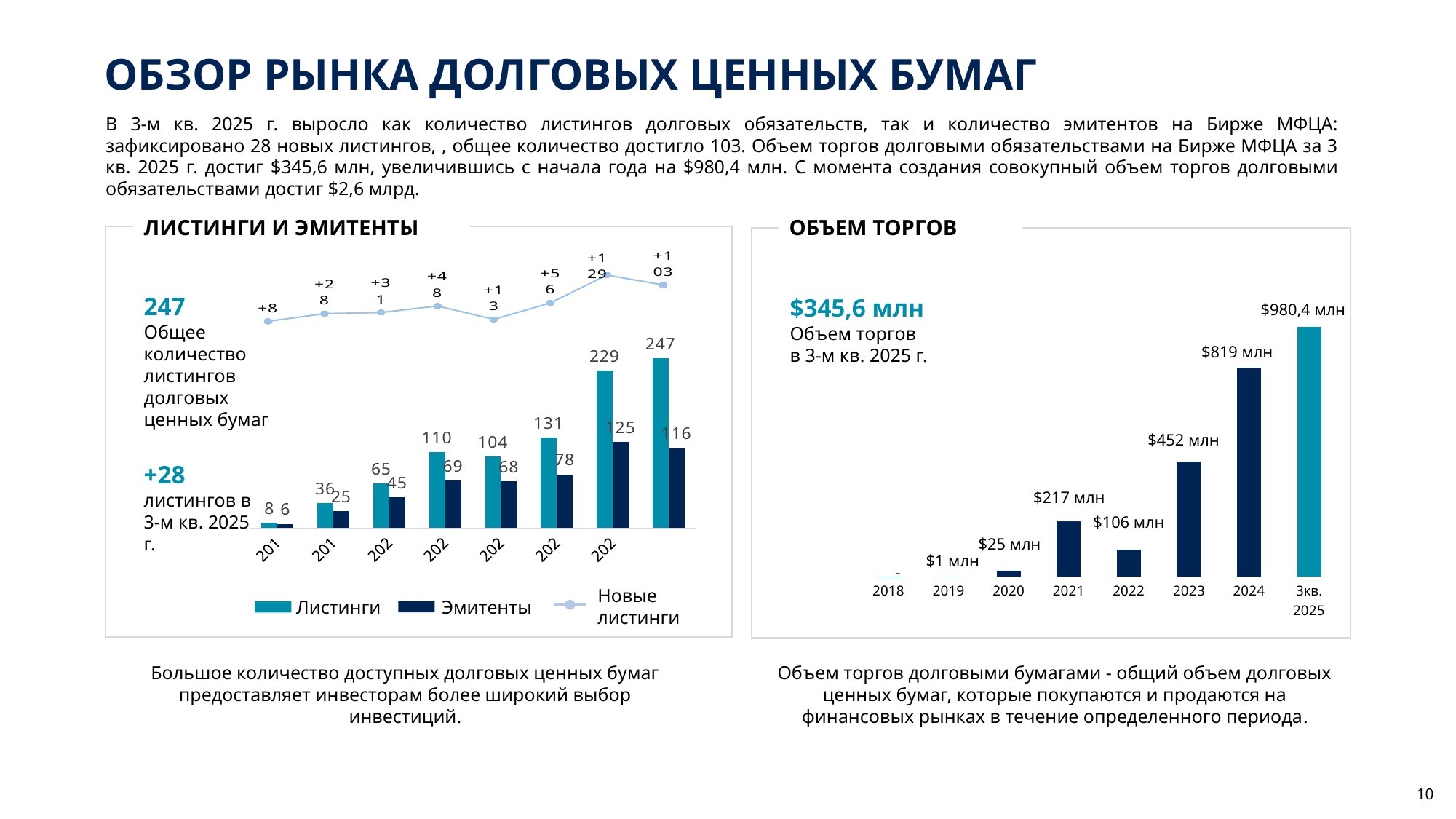
In the ЛИСТИНГИ И ЭМИТЕНТЫ chart, what is the highest value shown for the Листинги series? 247 What kind of chart is the ОБЪЕМ ТОРГОВ chart? bar chart In the ЛИСТИНГИ И ЭМИТЕНТЫ chart, what is the highest value shown for the Эмитенты series? 125 In the ОБЪЕМ ТОРГОВ chart, what is the value for 3кв. 2025? $980,4 млн How many series does the legend of the ЛИСТИНГИ И ЭМИТЕНТЫ chart list? 3 How many periods are shown on the x axis of the ОБЪЕМ ТОРГОВ chart? 8 In the ЛИСТИНГИ И ЭМИТЕНТЫ chart, which series is shown as a line rather than bars? Новые листинги In the ОБЪЕМ ТОРГОВ chart, which is larger, the value for 2021 or for 2022? 2021 In the ОБЪЕМ ТОРГОВ chart, which period has the highest trading volume? 3кв. 2025 In the ОБЪЕМ ТОРГОВ chart, what is the trading volume for 2021? $217 млн In the ОБЪЕМ ТОРГОВ chart, what is the trading volume for 2024? $819 млн In the ОБЪЕМ ТОРГОВ chart, what is the difference between the 2024 and 2023 values? $367 млн